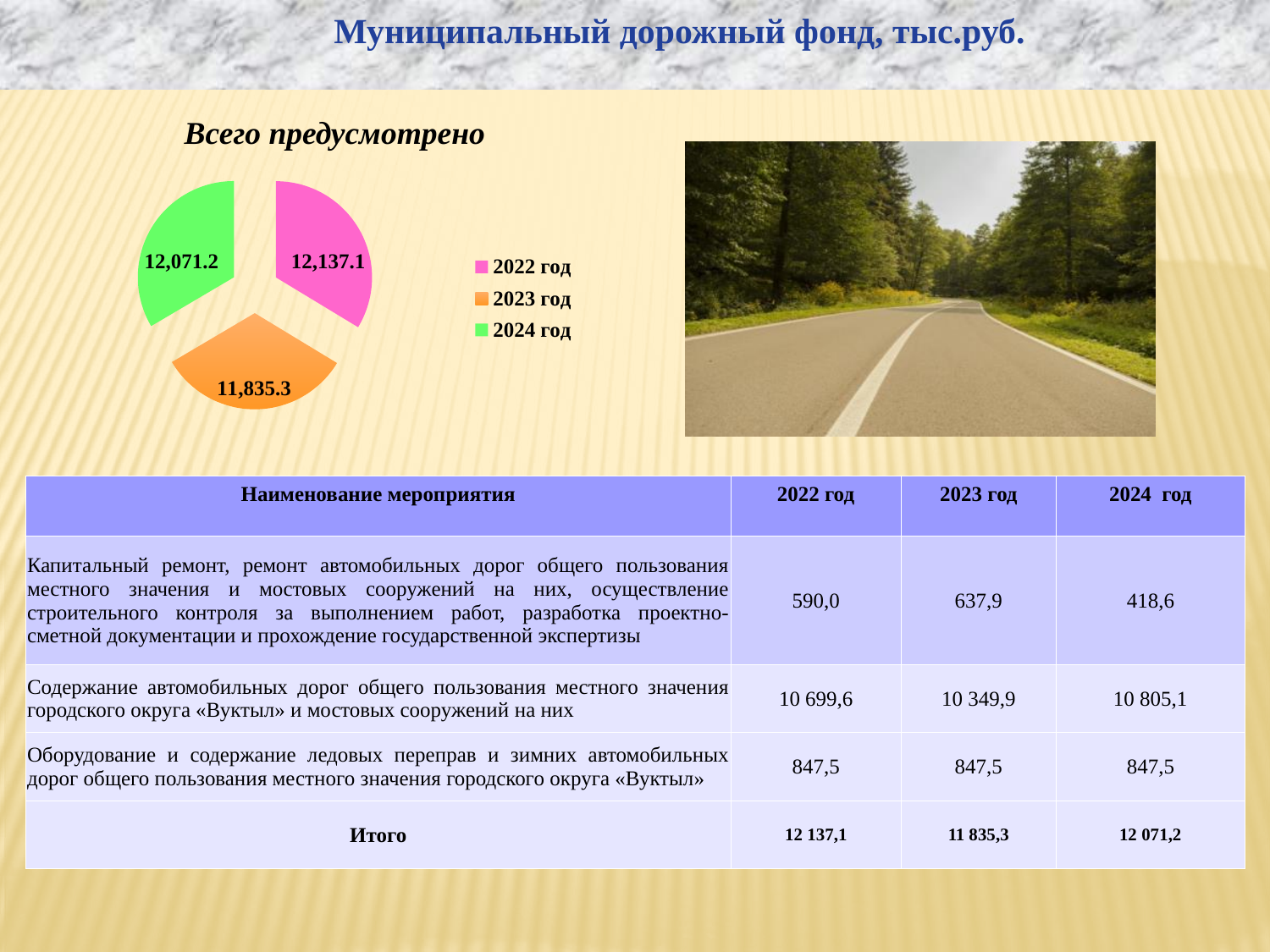
Which is larger in the pie chart, the value for 2024 год or the value for 2023 год? 2024 год What is the difference between the values for 2022 год and 2023 год in the pie chart? 301.8 What is the title of the pie chart? Всего предусмотрено What is the value shown for 2023 год in the pie chart? 11,835.3 How many entries does the legend of the pie chart list? 3 How many slices does the pie chart have? 3 What type of chart is shown on the slide? pie chart Which year has the largest value in the pie chart? 2022 год What is the value shown for 2024 год in the pie chart? 12,071.2 Which colour represents 2023 год in the pie chart? orange What is the value shown for 2022 год in the pie chart? 12,137.1 Which year has the smallest value in the pie chart? 2023 год